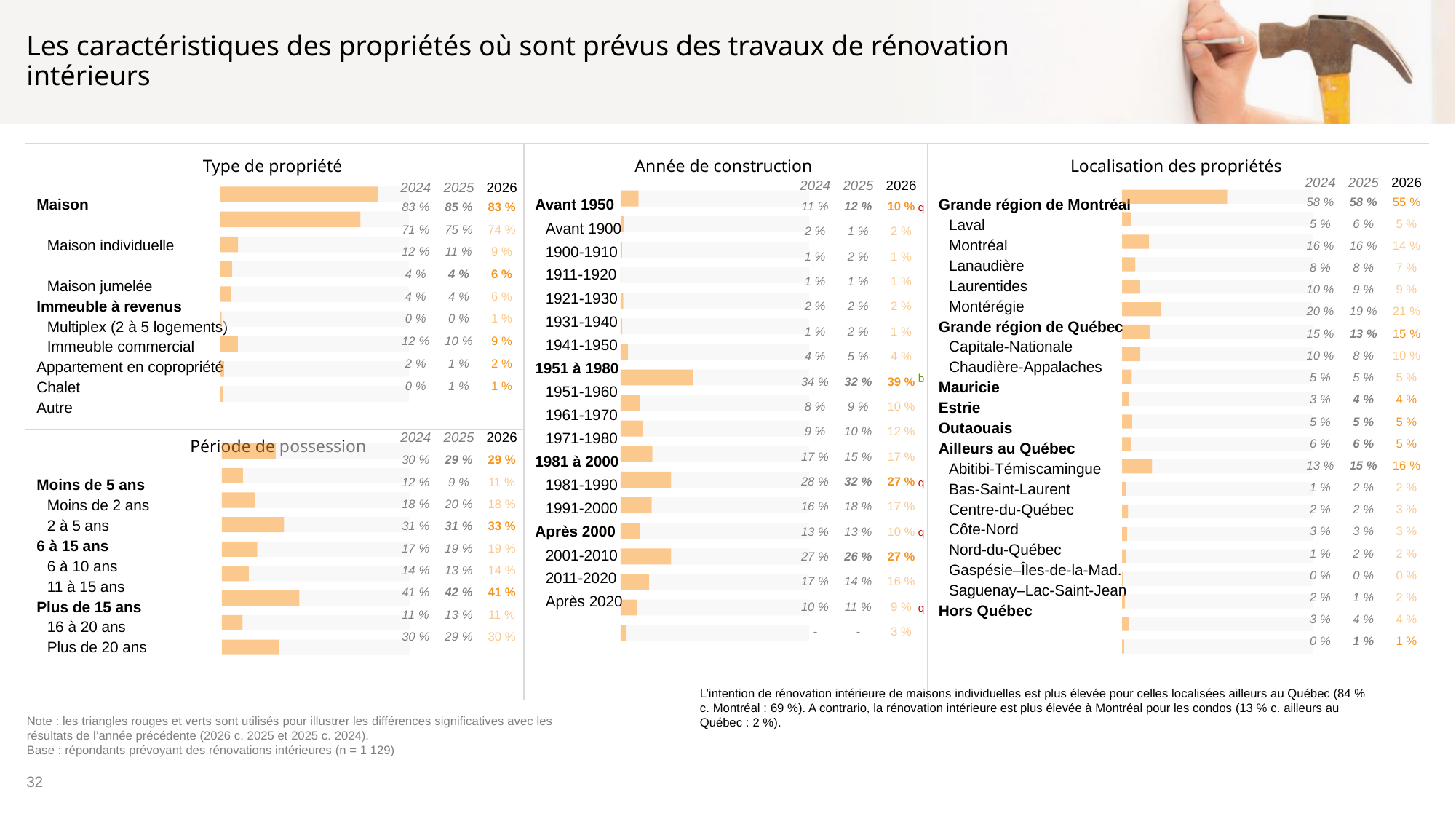
In the 'Période de possession' chart, what is the 2026 value for Plus de 15 ans? 41 % In the 'Type de propriété' chart, what is the 2026 value for Maison? 83 % In the 'Localisation des propriétés' chart, what is the 2026 value for Montérégie? 21 % In the 'Localisation des propriétés' chart, what is the 2026 value for Grande région de Montréal? 55 % In the 'Période de possession' chart, which of the three main groups (Moins de 5 ans, 6 à 15 ans, Plus de 15 ans) has the highest 2026 value? Plus de 15 ans In the 'Localisation des propriétés' chart, which is larger in 2026: Grande région de Québec or Ailleurs au Québec? Ailleurs au Québec In the 'Année de construction' chart, what is the difference between the 2026 and 2025 values for 1951 à 1980? 7 % In the 'Type de propriété' chart, which category has the highest 2026 value? Maison In the 'Année de construction' chart, what is the 2026 value for 1951 à 1980? 39 % In the 'Type de propriété' chart, what is the 2025 value for Maison individuelle? 75 % What kind of chart is used in the 'Localisation des propriétés' panel? Bar chart In the 'Année de construction' chart, what is the 2026 value for Après 2020? 3 %